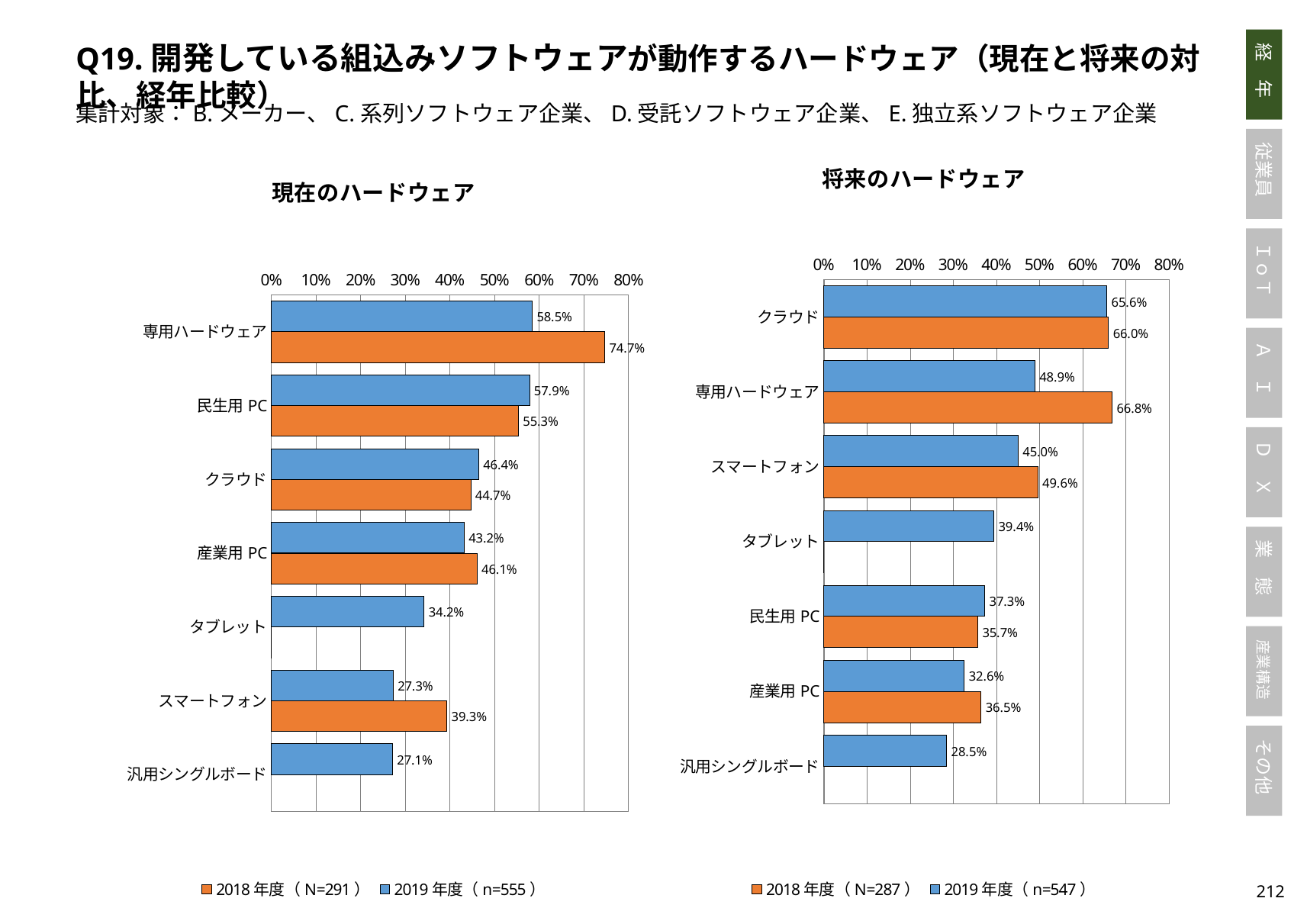
How many categories are shown in the 現在のハードウェア chart? 7 In the 現在のハードウェア chart, what is the 2018年度 value for スマートフォン? 39.3% How many series does the legend of the 将来のハードウェア chart list? 2 In the 将来のハードウェア chart, is the 2019年度 value for クラウド greater or less than 60%? greater In the 現在のハードウェア chart, which category has the highest 2018年度 value? 専用ハードウェア What type of chart is the 現在のハードウェア chart? Bar chart In the 将来のハードウェア chart, what is the 2018年度 value for 専用ハードウェア? 66.8% In the 将来のハードウェア chart, which is larger for 産業用 PC: the 2018年度 value or the 2019年度 value? 2018年度 In the 将来のハードウェア chart, what is the 2019年度 value for 汎用シングルボード? 28.5% In the 現在のハードウェア chart, what is the difference between the 2018年度 and 2019年度 values for 専用ハードウェア? 16.2% In the 将来のハードウェア chart, which category has the lowest 2019年度 value? 汎用シングルボード In the 現在のハードウェア chart, what is the 2019年度 value for 専用ハードウェア? 58.5%